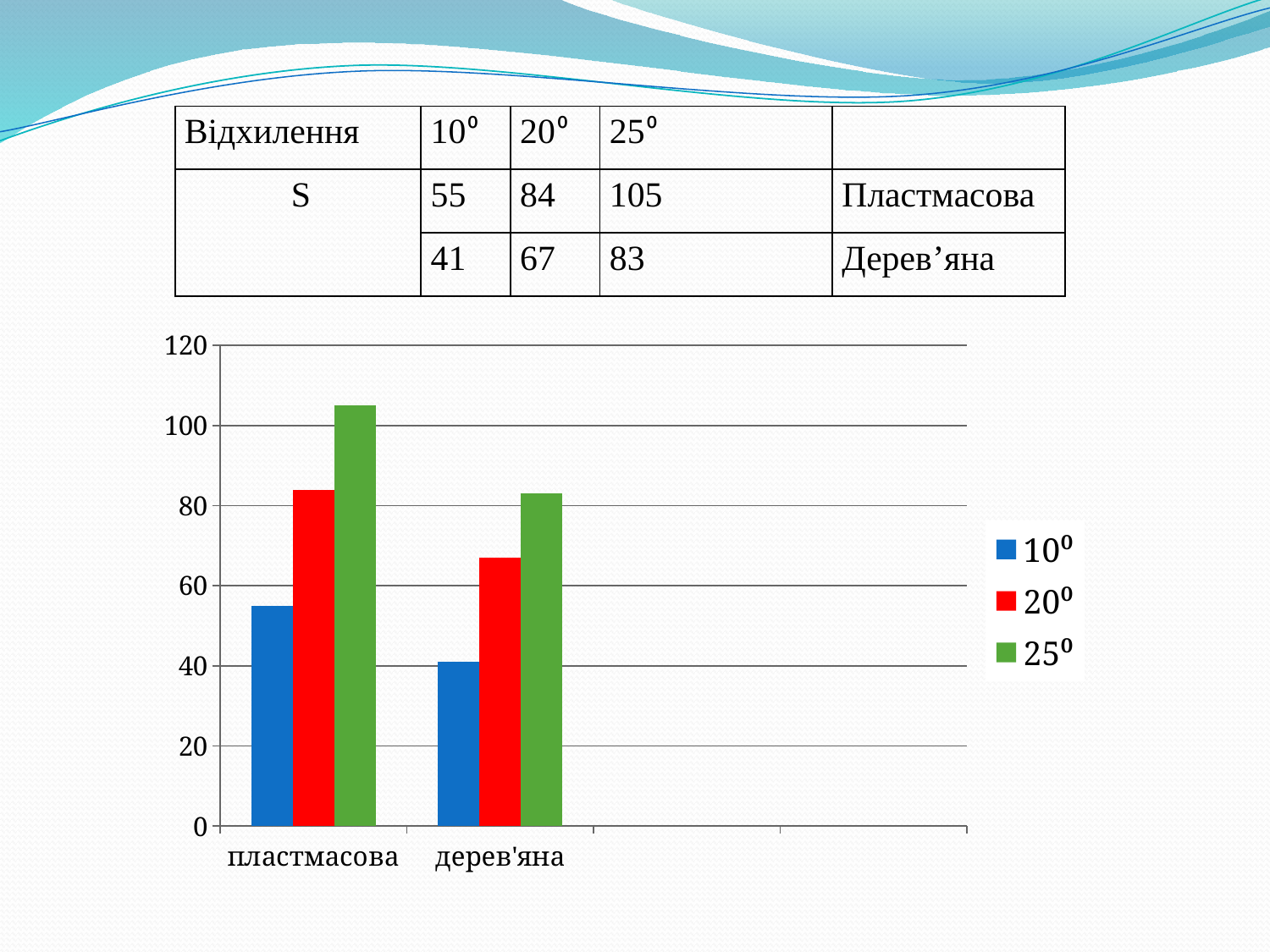
Within each series, do the values rise or fall from пластмасова to дерев'яна? fall How many series does the chart legend list? 3 Is the value of the 10⁰ series for пластмасова greater or less than 60? less What is the value of the 20⁰ series for дерев'яна? 67 What is the difference between the 25⁰ values for пластмасова and дерев'яна? 22 What colour represents the 20⁰ series in the chart? red What kind of chart is shown on the slide? bar chart For the 10⁰ series, which category has the larger value, пластмасова or дерев'яна? пластмасова Which bar in the chart is the shortest? 10⁰ for дерев'яна Which bar in the chart is the tallest? 25⁰ for пластмасова How many categories are shown on the x axis of the chart? 2 What is the value of the 25⁰ series for пластмасова? 105